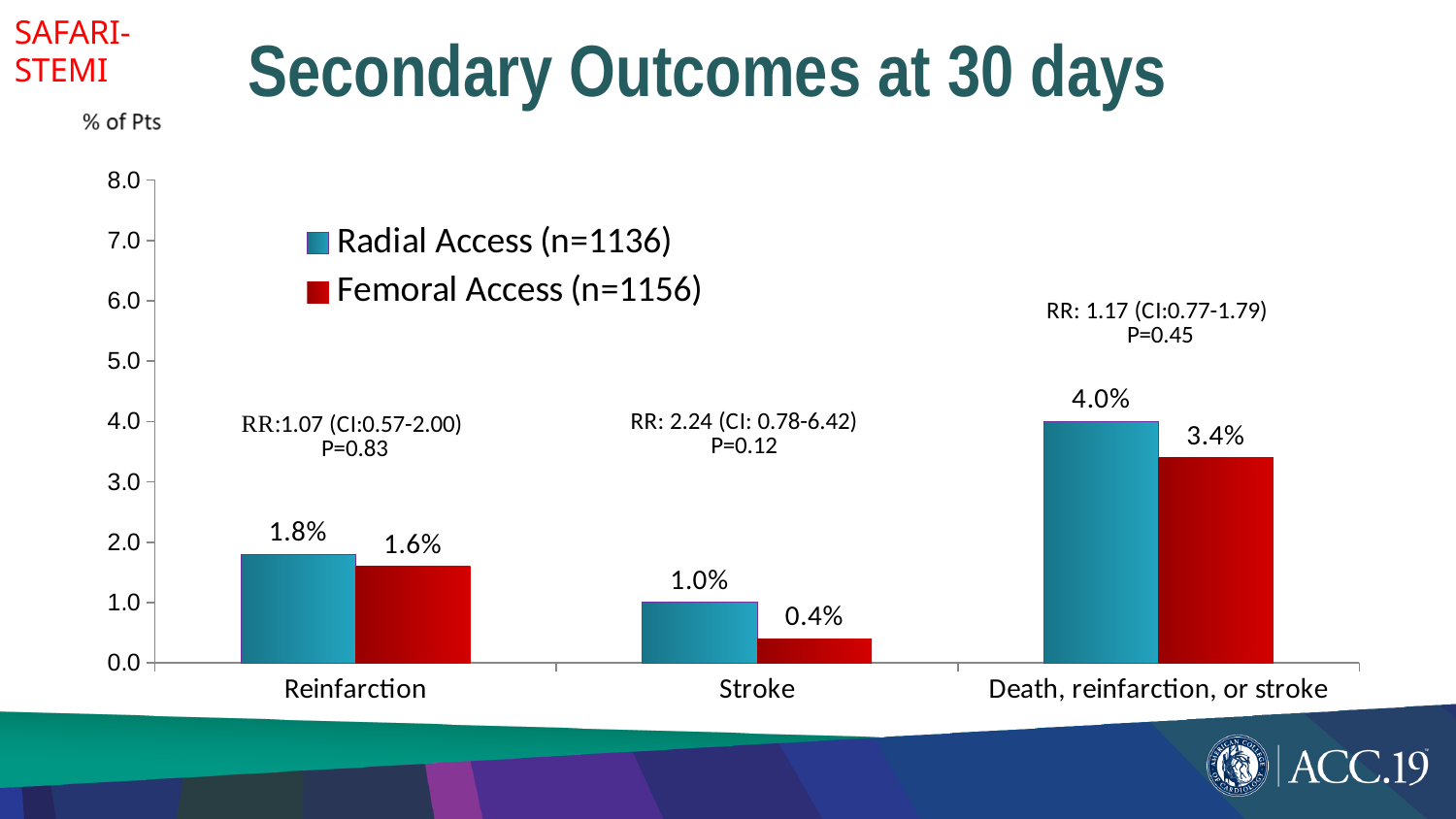
How many outcome categories are shown on the x axis? 3 Which is larger for Reinfarction, the Radial Access value or the Femoral Access value? Radial Access What is the Femoral Access value for Reinfarction? 1.6% What is the difference between the Radial Access and Femoral Access values for Death, reinfarction, or stroke? 0.6% Which category has the lowest Femoral Access value? Stroke How many series does the legend list? 2 What is the Radial Access value for Stroke? 1.0% What is the Femoral Access value for Death, reinfarction, or stroke? 3.4% What is the P value shown for the Stroke comparison? P=0.12 What is the difference between the Radial Access and Femoral Access values for Stroke? 0.6% What kind of chart is shown on the slide? Bar chart Which category has the highest Radial Access value? Death, reinfarction, or stroke